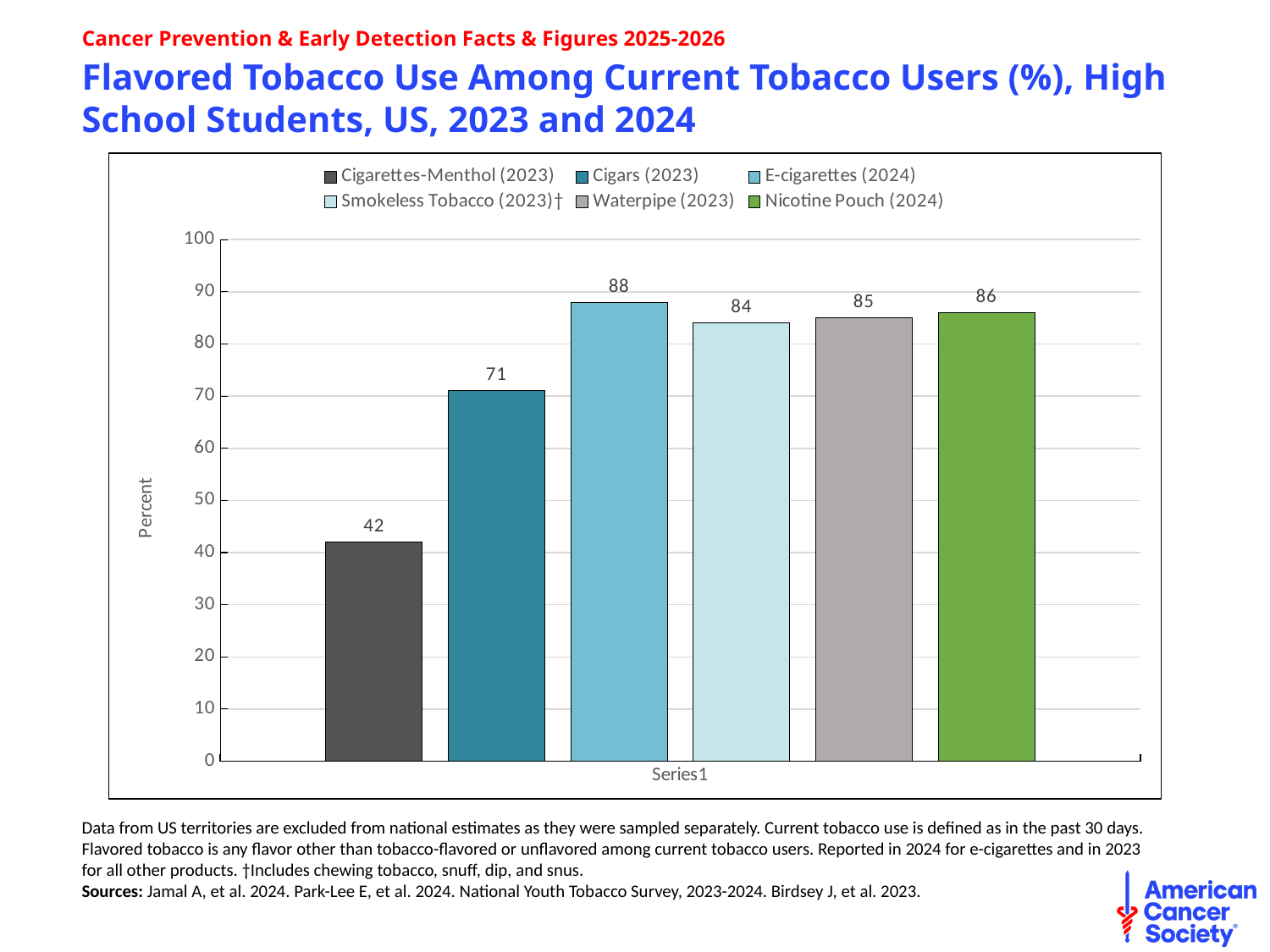
How many series does the legend list? 6 Is the value for Cigars (2023) greater or less than 80? less Which product has the lowest flavored tobacco use percentage? Cigarettes-Menthol (2023) How many bars are plotted in the chart? 6 What is the value for Smokeless Tobacco (2023)? 84 What is the difference between the values for E-cigarettes (2024) and Cigars (2023)? 17 What is the value for E-cigarettes (2024)? 88 Which is larger, the value for Cigars (2023) or the value for Waterpipe (2023)? Waterpipe (2023) What is the value for Cigarettes-Menthol (2023)? 42 What is the value for Nicotine Pouch (2024)? 86 What kind of chart is shown on the slide? Bar chart Which product has the highest flavored tobacco use percentage? E-cigarettes (2024)